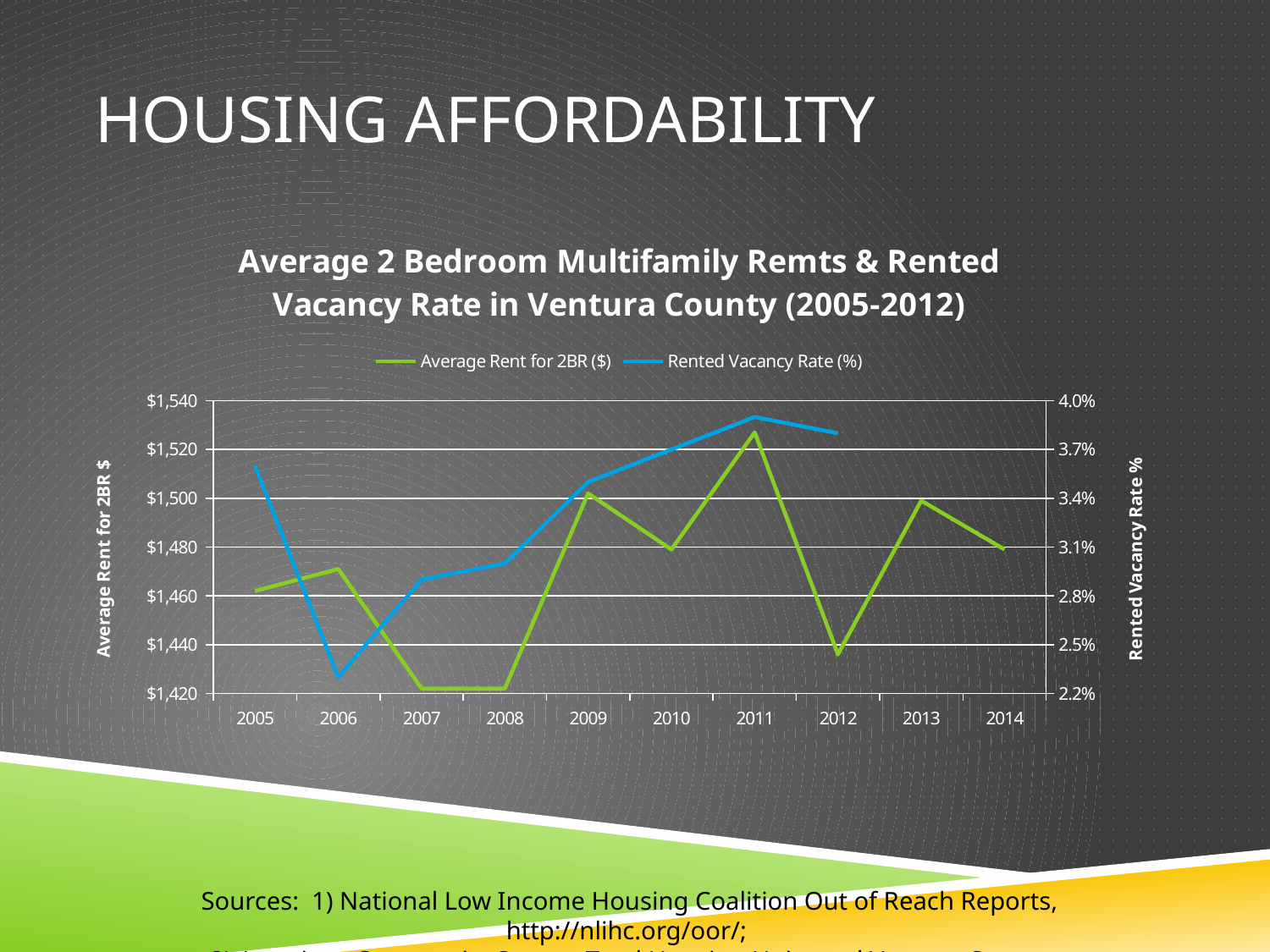
Is the Average Rent for 2BR ($) in 2012 greater or less than $1,440? less What is the label on the right-hand vertical axis? Rented Vacancy Rate % In which year is the Rented Vacancy Rate (%) highest? 2011 In which year is the Rented Vacancy Rate (%) lowest? 2006 How many years are shown along the x axis? 10 Which year has a higher Average Rent for 2BR ($), 2009 or 2012? 2009 Is the Rented Vacancy Rate (%) in 2006 greater or less than 2.5%? less In which year is the Average Rent for 2BR ($) highest? 2011 What kind of chart is shown on the slide? line chart How many series does the legend list? 2 Does the Rented Vacancy Rate (%) rise or fall from 2005 to 2006? fall Is the Average Rent for 2BR ($) in 2011 greater or less than $1,520? greater